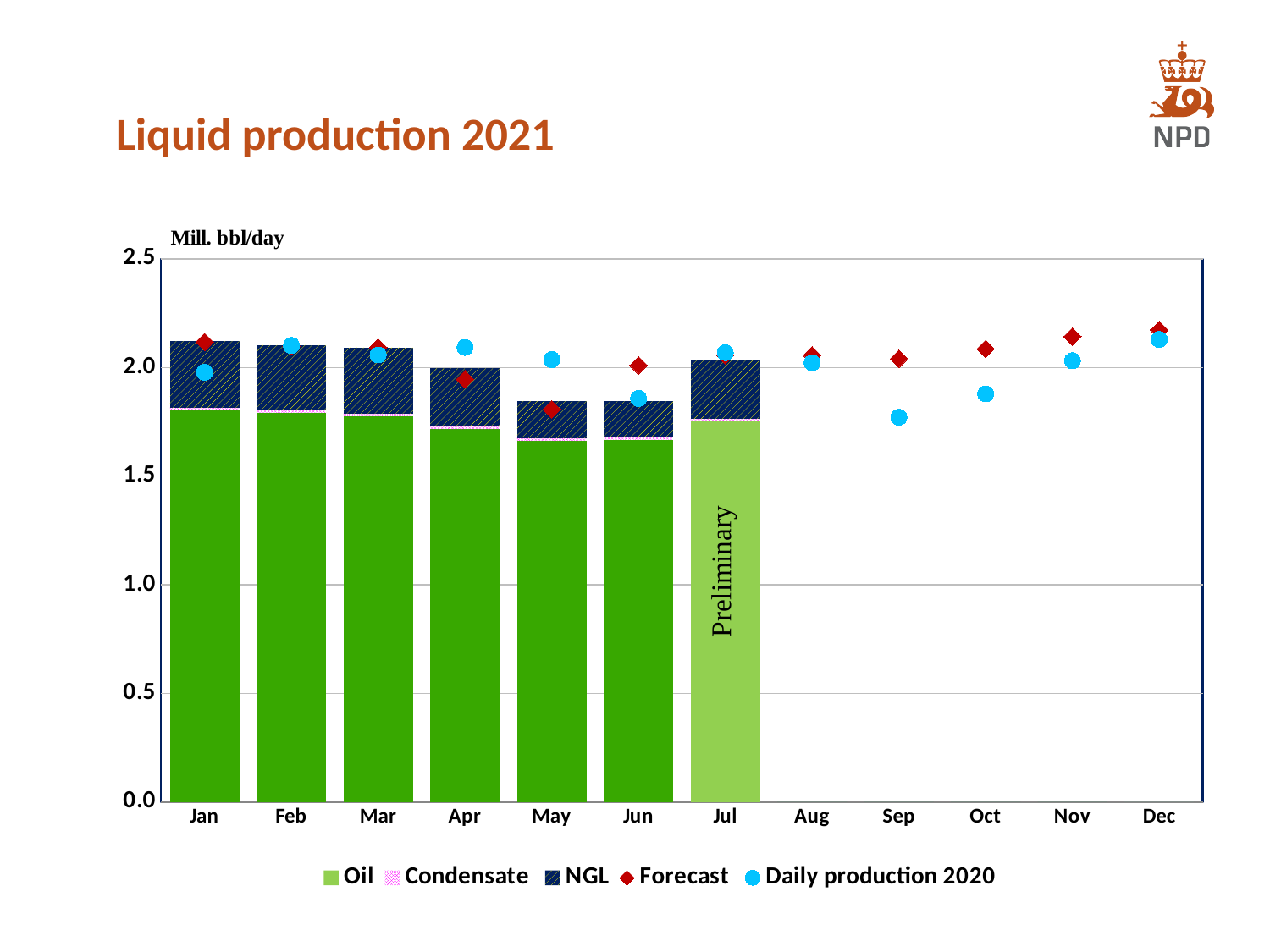
What kind of chart is shown on the slide? combination chart (stacked bars with point markers) In Sep, which is larger: the Forecast value or the Daily production 2020 value? Forecast Is the total of the stacked bar for Jan greater or less than 2.0? greater How many months have a stacked bar plotted? 7 Is the total of the stacked bar for May greater or less than 2.0? less How many series does the legend list? 5 How many months are labelled on the x axis? 12 Do the Forecast values rise or fall from Aug to Dec? rise What is the title of the chart? Liquid production 2021 What unit is shown on the y axis of the chart? Mill. bbl/day Is the Daily production 2020 value for Sep greater or less than 2.0? less In Apr, which is larger: the Forecast value or the Daily production 2020 value? Daily production 2020